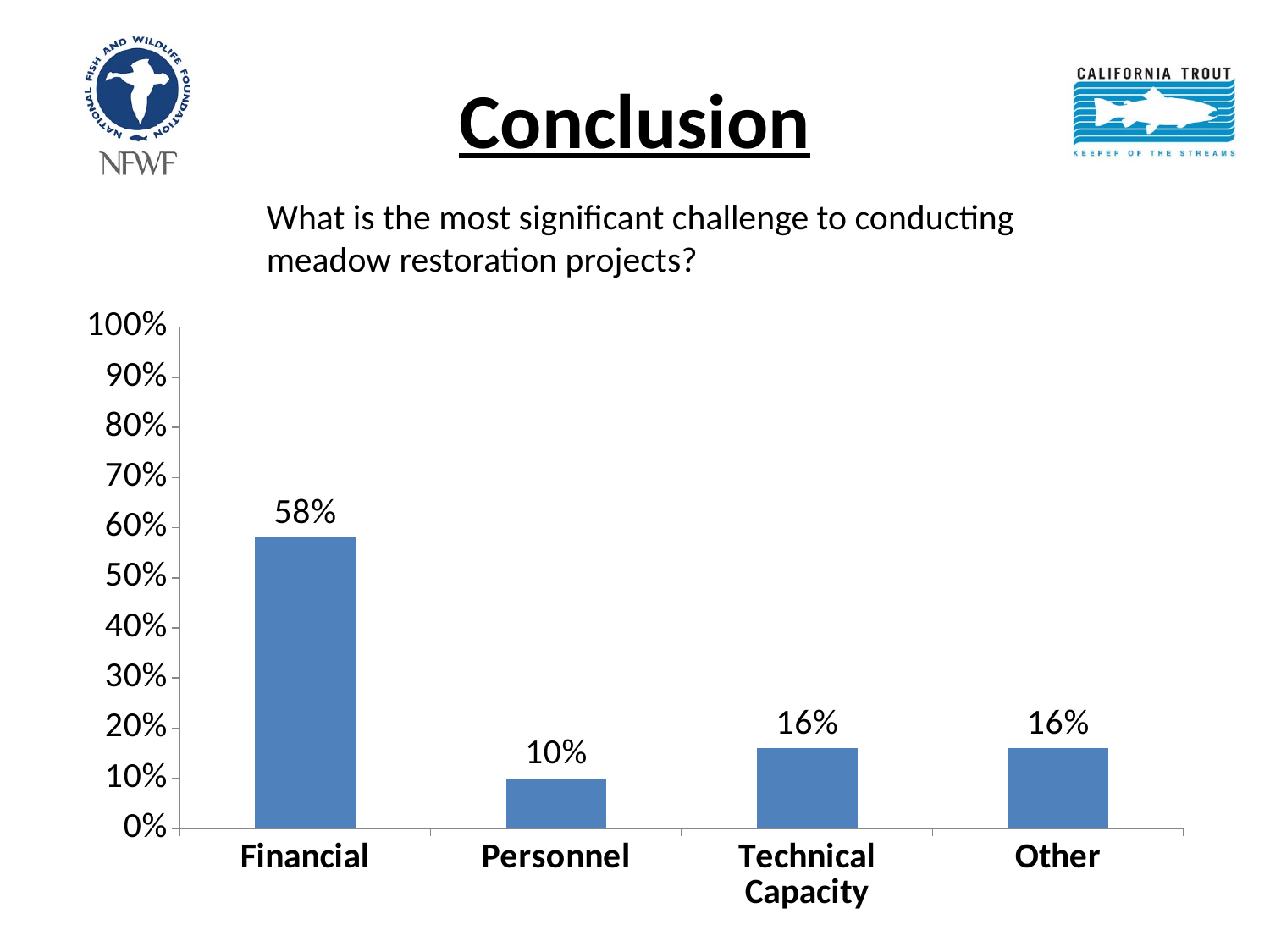
Is the value for Financial greater or less than 50%? greater What is the value shown for Personnel? 10% What is the difference between the Financial and Personnel values? 48% Which category has the highest value? Financial What kind of chart is shown on the slide? Bar chart What percentage of respondents chose Financial as the most significant challenge? 58% Which is larger, the value for Financial or the value for Other? Financial What is the value shown for Technical Capacity? 16% What is the difference between the Technical Capacity and Personnel values? 6% How many categories are shown on the x axis? 4 What question does the chart answer, according to the text above it? What is the most significant challenge to conducting meadow restoration projects? Which category has the lowest value? Personnel